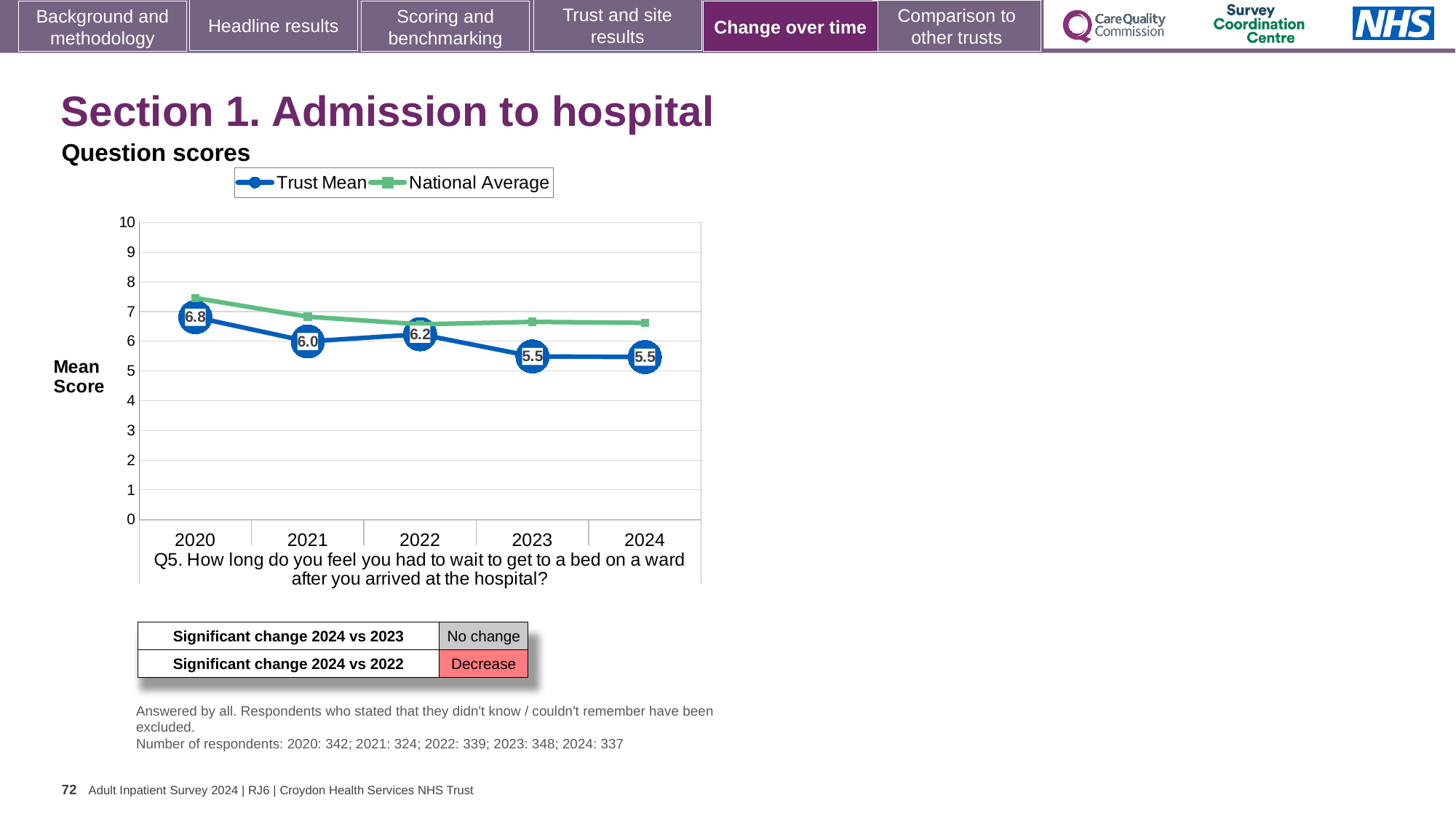
How many years are plotted on the x axis? 5 In which year is the Trust Mean score highest? 2020 Is the National Average value for 2020 greater or less than 7? greater What is the lowest Trust Mean score shown on the chart? 5.5 Which is larger, the Trust Mean score in 2021 or in 2022? 2022 What is the difference between the Trust Mean score in 2020 and in 2024? 1.3 What is the Trust Mean score for 2023? 5.5 What is the Trust Mean score for 2020? 6.8 What is the Trust Mean score for 2022? 6.2 How many series does the legend list? 2 What kind of chart is shown on the slide? Line chart Is the National Average value for 2024 greater or less than 6? greater